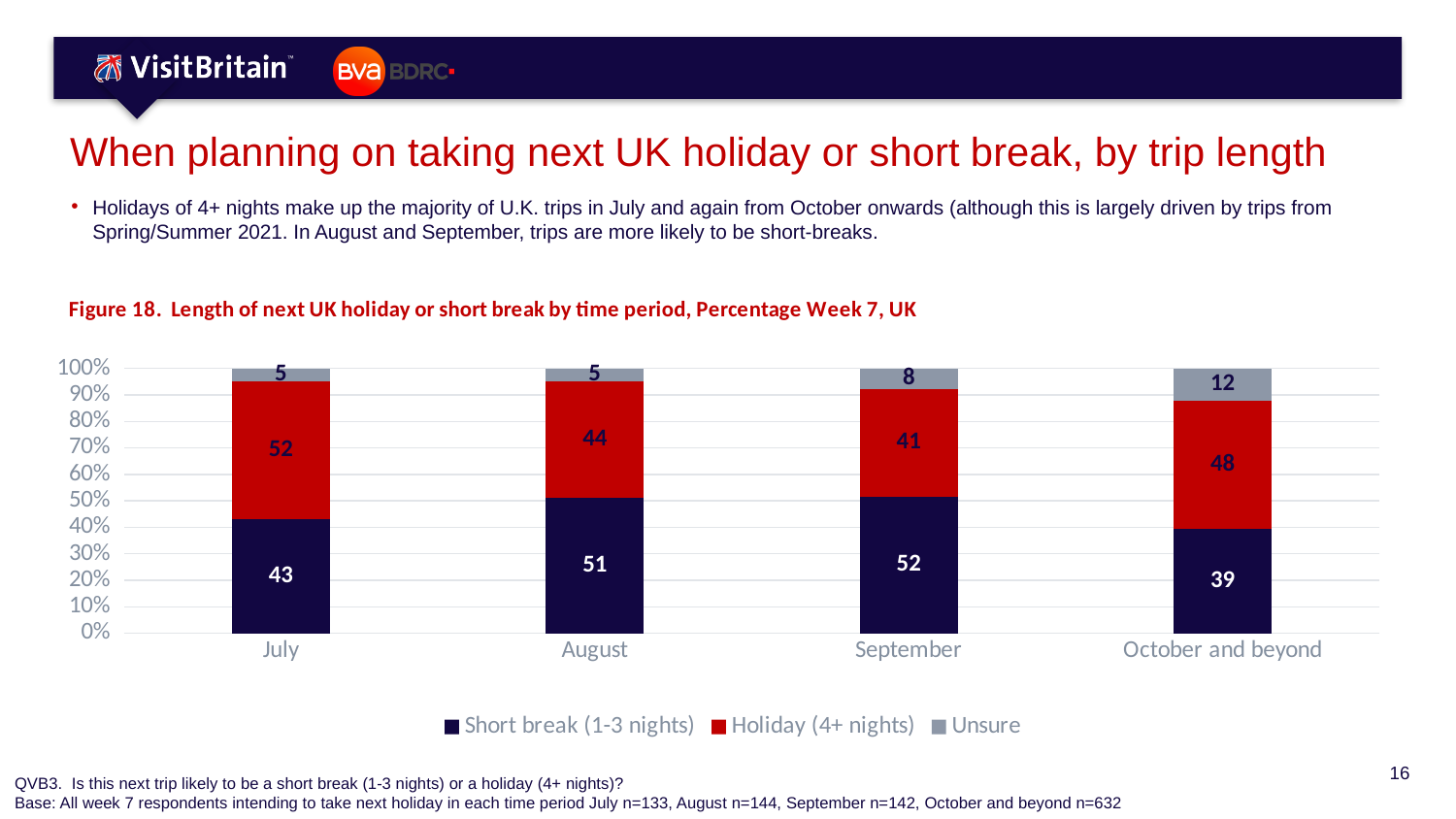
Which time period has the highest value for Short break (1-3 nights)? September What is the value for Unsure in September? 8 Which time period has the lowest value for Holiday (4+ nights)? September What is the difference between the Holiday (4+ nights) value in July and in August? 8 What kind of chart is shown? Stacked bar chart What is the value for Short break (1-3 nights) in July? 43 How many series does the legend list? 3 How many time periods are shown on the x axis? 4 What is the value for Holiday (4+ nights) in October and beyond? 48 Which is larger: the Short break (1-3 nights) value in August or in October and beyond? August What colour represents Holiday (4+ nights) in the chart? Red What is the total of the Short break (1-3 nights) and Holiday (4+ nights) values for October and beyond? 87